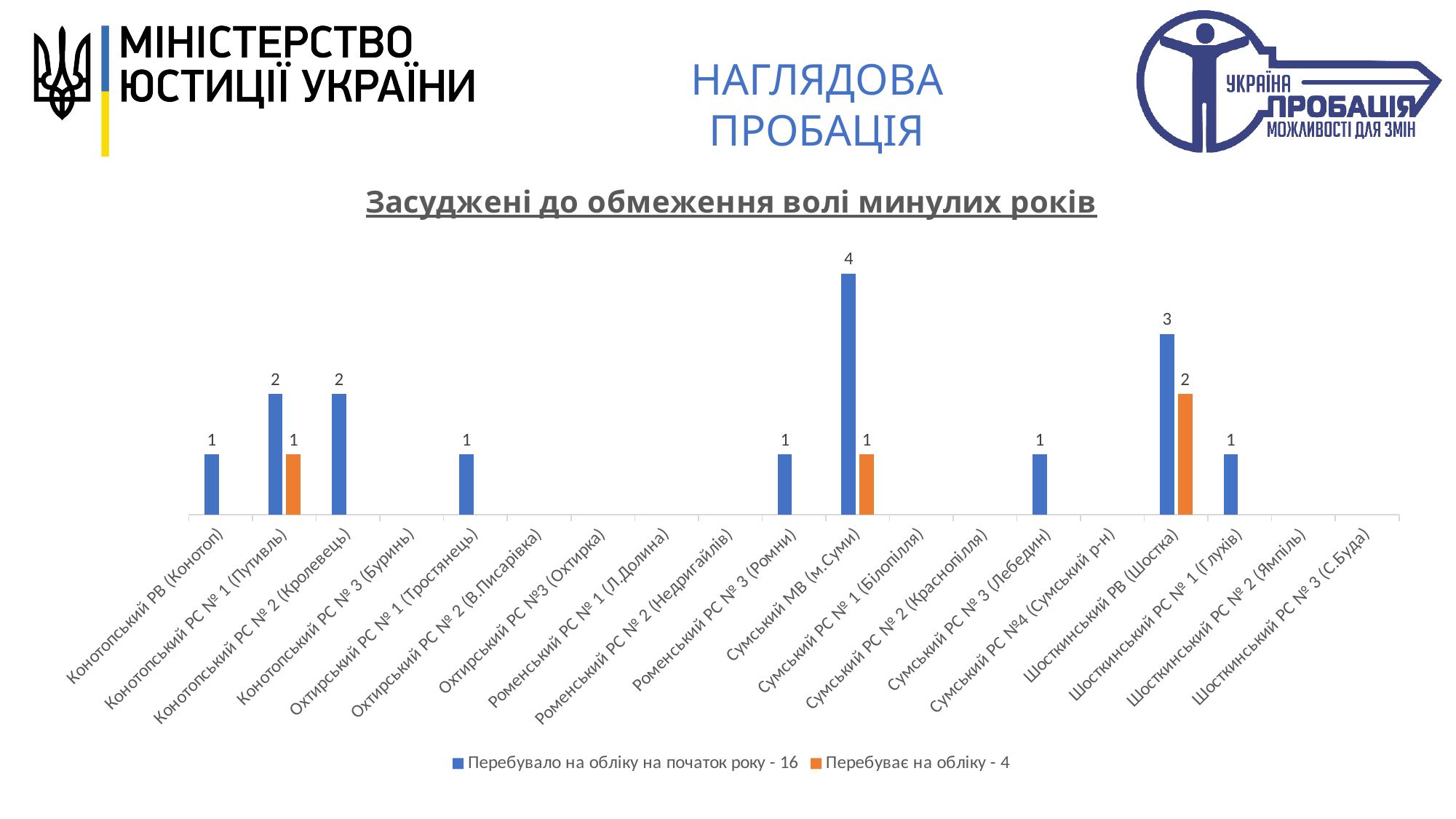
What is the title of the chart? Засуджені до обмеження волі минулих років What is the value of 'Перебувало на обліку на початок року' for Конотопський РС № 2 (Кролевець)? 2 Which category has the highest value for 'Перебуває на обліку'? Шосткинський РВ (Шостка) Which is larger for Шосткинський РВ (Шостка): 'Перебувало на обліку на початок року' or 'Перебуває на обліку'? Перебувало на обліку на початок року How many categories are shown on the x axis? 19 Which category has the highest value for 'Перебувало на обліку на початок року'? Сумський МВ (м.Суми) What is the value of 'Перебувало на обліку на початок року' for Сумський МВ (м.Суми)? 4 What is the difference between the 'Перебувало на обліку на початок року' values for Сумський МВ (м.Суми) and Шосткинський РВ (Шостка)? 1 What is the value of 'Перебуває на обліку' for Шосткинський РВ (Шостка)? 2 What is the difference between 'Перебувало на обліку на початок року' and 'Перебуває на обліку' for Сумський МВ (м.Суми)? 3 What type of chart is shown on the slide? bar chart How many series does the legend list? 2